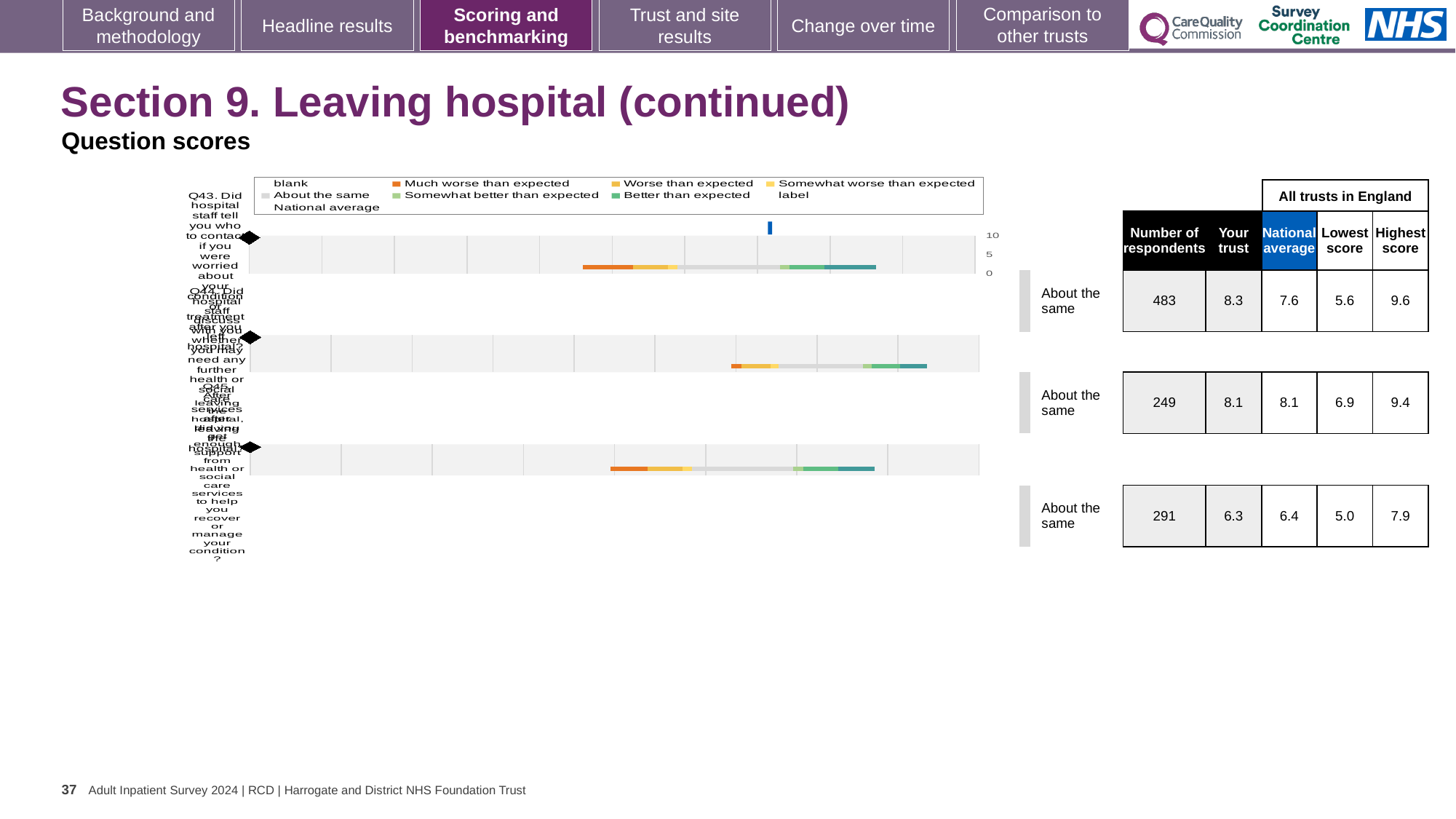
For the bottom chart (Q45), what is the difference between the highest score and the lowest score across all trusts in England? 2.9 For the bottom chart (Q45), is the 'Your trust' score greater or less than 5? greater What kind of chart is used to show the question scores on this slide? Bar chart How many question charts are shown on the slide? 3 What benchmark category is shown next to the middle chart (Q44)? About the same Which of the three questions has the highest 'Your trust' score? Q43 For the top chart (Q43), which is larger: the 'Your trust' score or the national average? Your trust In the legend, what colour represents 'Much worse than expected'? Orange For the bottom chart (Q45, enough support after leaving hospital), how many respondents are listed? 291 For the top chart (Q43, who to contact if worried after leaving hospital), what is the 'Your trust' score shown in the table? 8.3 For the middle chart (Q44, discussing further health or social care services), what is the national average score? 8.1 Which of the three questions has the lowest 'Your trust' score? Q45